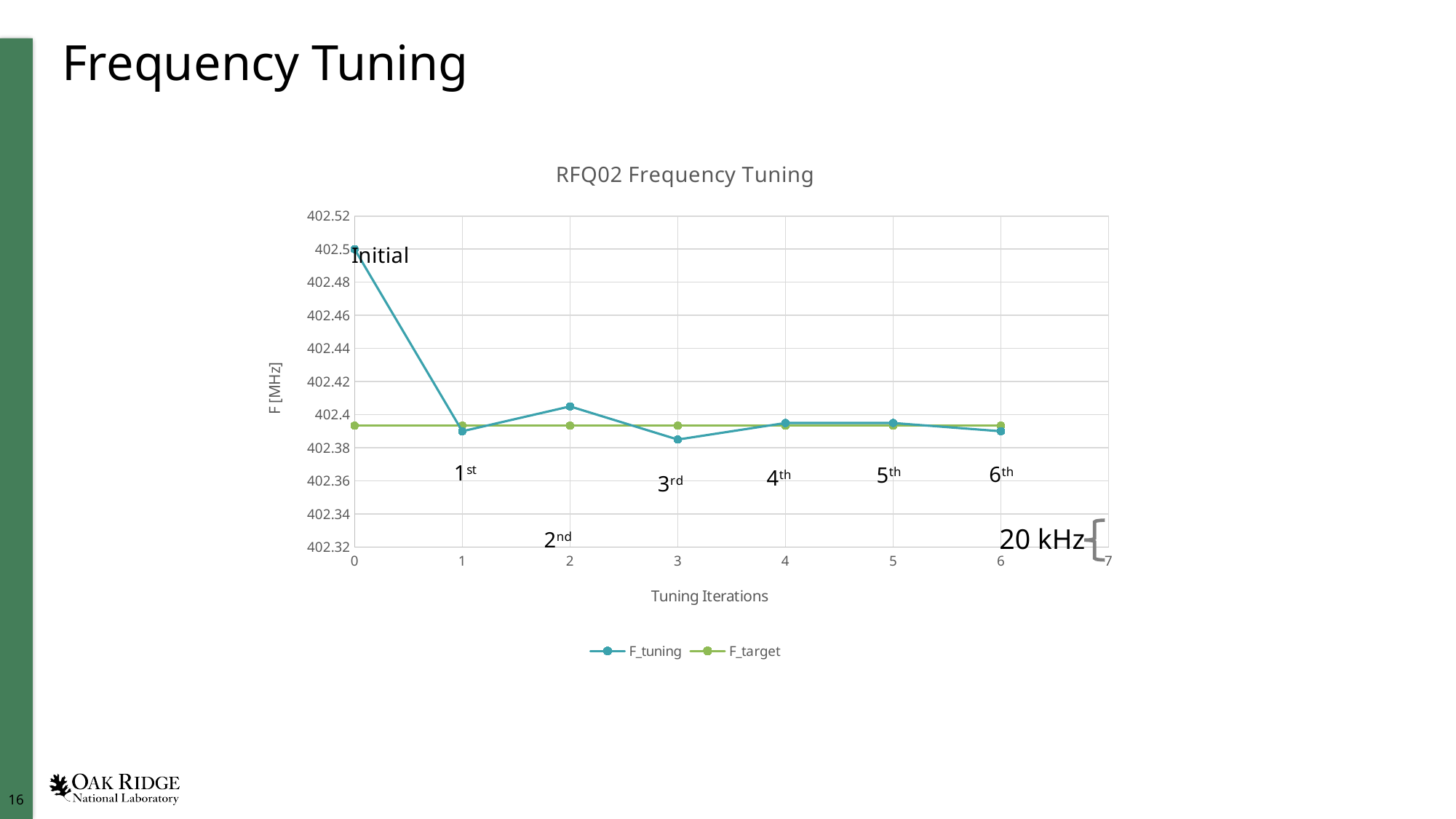
Is the F_tuning value at iteration 0 greater or less than 402.48? greater At which tuning iteration is the F_tuning value lowest? 3 Is the F_tuning value at iteration 3 greater or less than 402.4? less Which is larger, the F_tuning value at iteration 2 or at iteration 3? iteration 2 What kind of chart is shown on the slide? line chart What are the two series named in the legend? F_tuning and F_target What is the title of the chart? RFQ02 Frequency Tuning How many data points does the F_tuning series have? 7 How many series does the legend list? 2 Does the F_tuning value rise or fall from iteration 0 to iteration 1? fall Is the F_tuning value at iteration 2 greater or less than 402.4? greater At which tuning iteration is the F_tuning value highest? 0 (Initial)